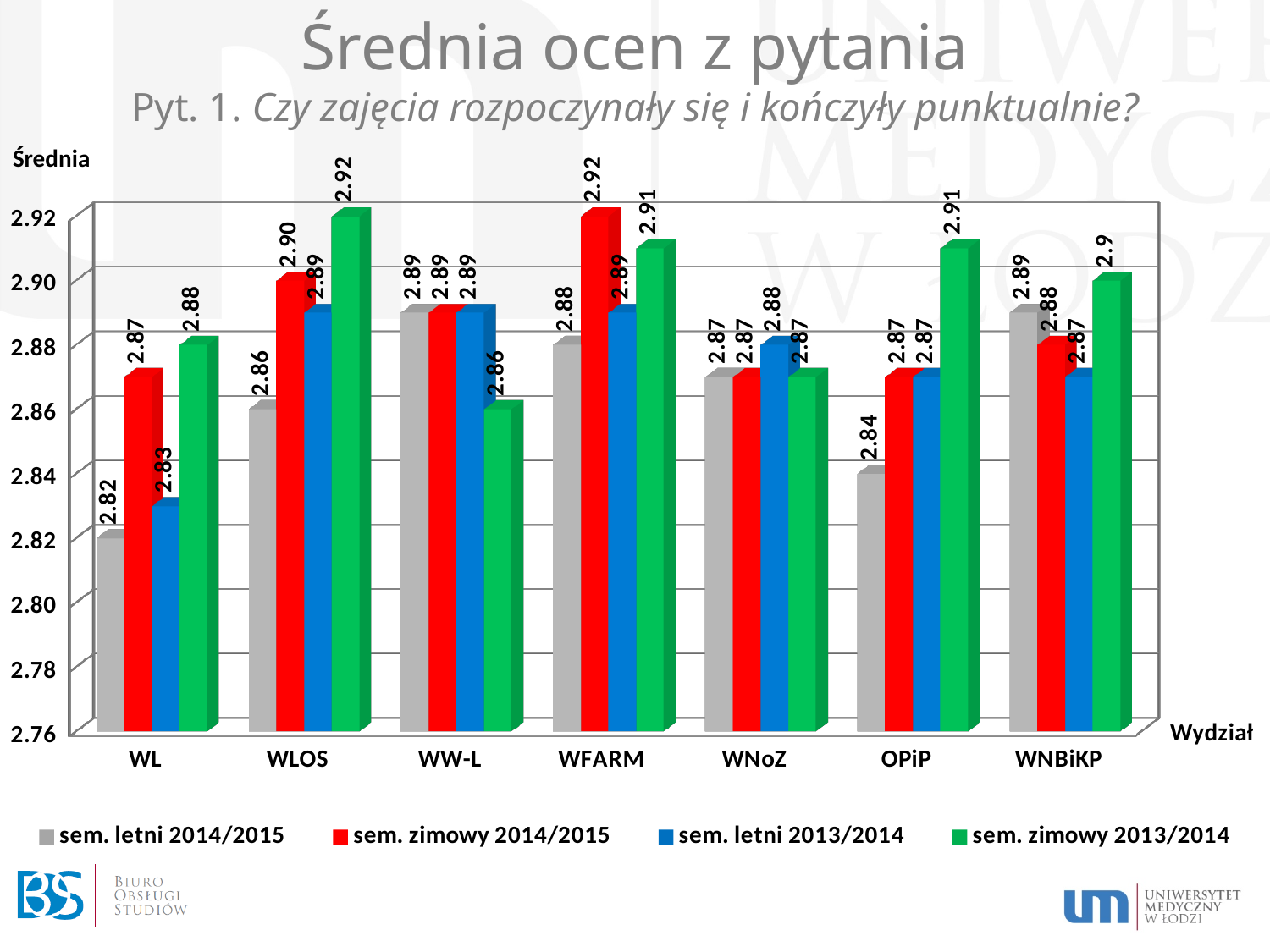
How many faculties (categories) are shown on the x axis? 7 Which faculty has the lowest value in the sem. letni 2014/2015 series? WL How many series does the legend list? 4 Which is larger in the sem. letni 2014/2015 series: OPiP or WNBiKP? WNBiKP What is the value for WNBiKP in the sem. zimowy 2013/2014 series? 2.9 What colour represents the sem. letni 2013/2014 series in the legend? blue What is the value for WFARM in the sem. zimowy 2014/2015 series? 2.92 What kind of chart is shown on the slide? bar chart What is the value for WL in the sem. letni 2014/2015 series? 2.82 Which faculty has the highest value in the sem. zimowy 2014/2015 series? WFARM What is the value for WW-L in the sem. zimowy 2013/2014 series? 2.86 What is the difference between the sem. zimowy 2013/2014 value and the sem. letni 2014/2015 value for WLOS? 0.06